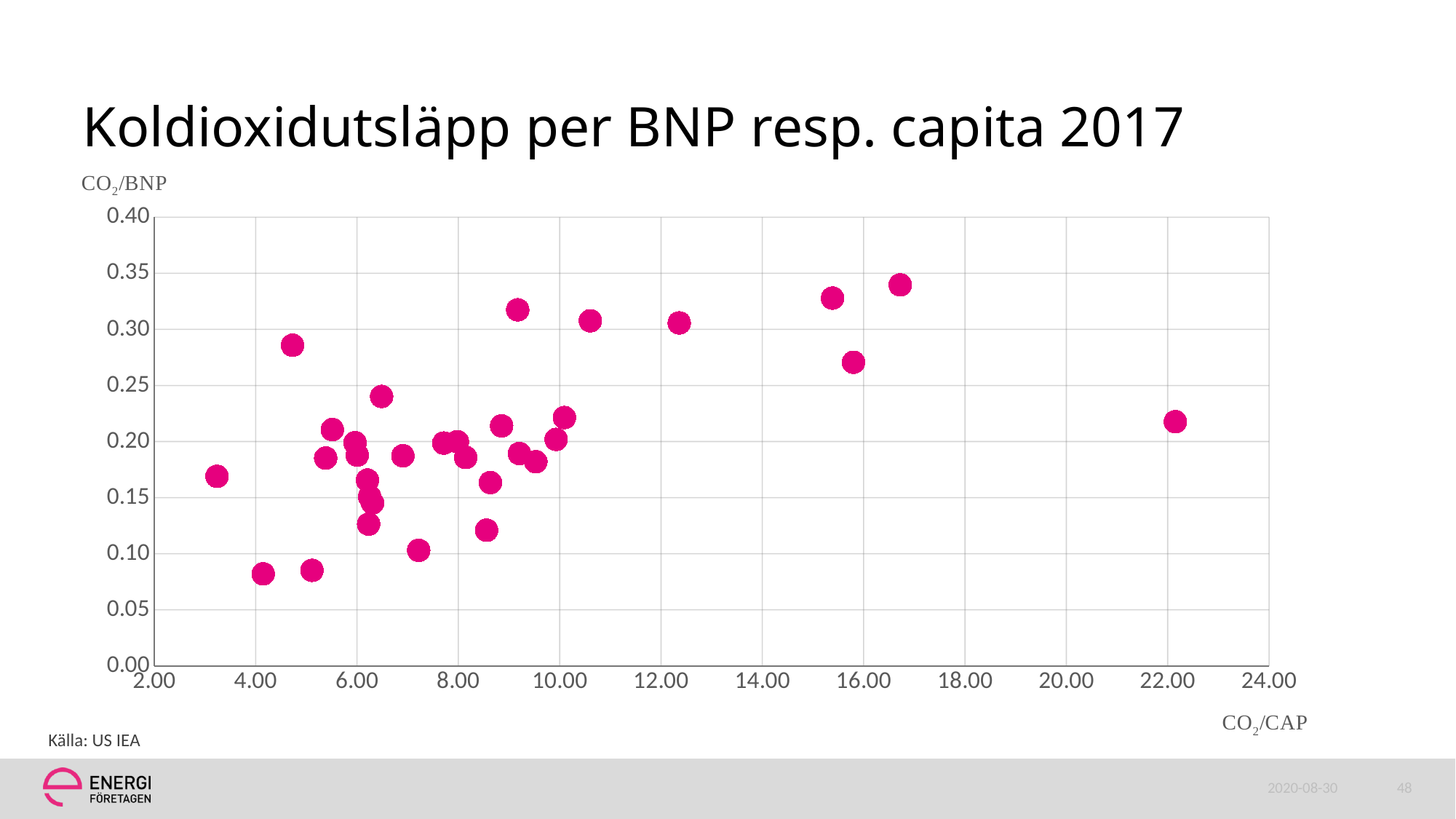
What is the label of the horizontal axis? CO2/CAP Is the CO2/BNP value of the highest point greater or less than 0.30? greater Is the CO2/CAP value of the highest point greater or less than 14.00? greater What is the title of the chart? Koldioxidutsläpp per BNP resp. capita 2017 What kind of chart is shown on the slide? scatter plot Is the CO2/CAP value of the leftmost point greater or less than 4.00? less